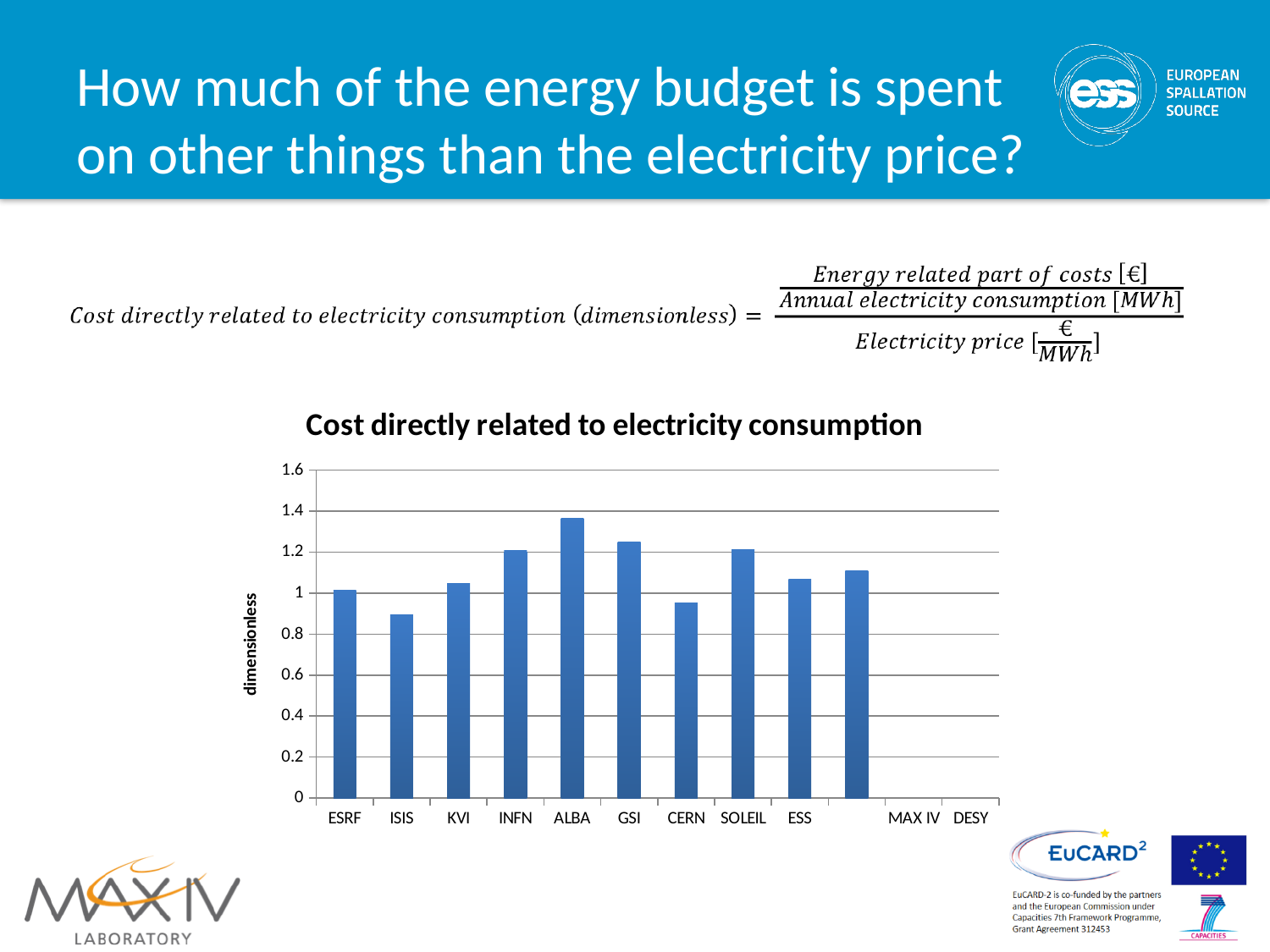
Which facility has the lowest bar in the chart? ISIS What is the label on the vertical axis of the chart? dimensionless Is the value for GSI greater or less than 1.2? greater Is the value for ISIS greater or less than 1? less What kind of chart is shown on the slide? bar chart Is the value for ESS greater or less than 1? greater Which facility has the highest cost directly related to electricity consumption? ALBA What is the title of the chart? Cost directly related to electricity consumption How many facility labels are shown on the horizontal axis? 11 Which has the larger value, GSI or KVI? GSI